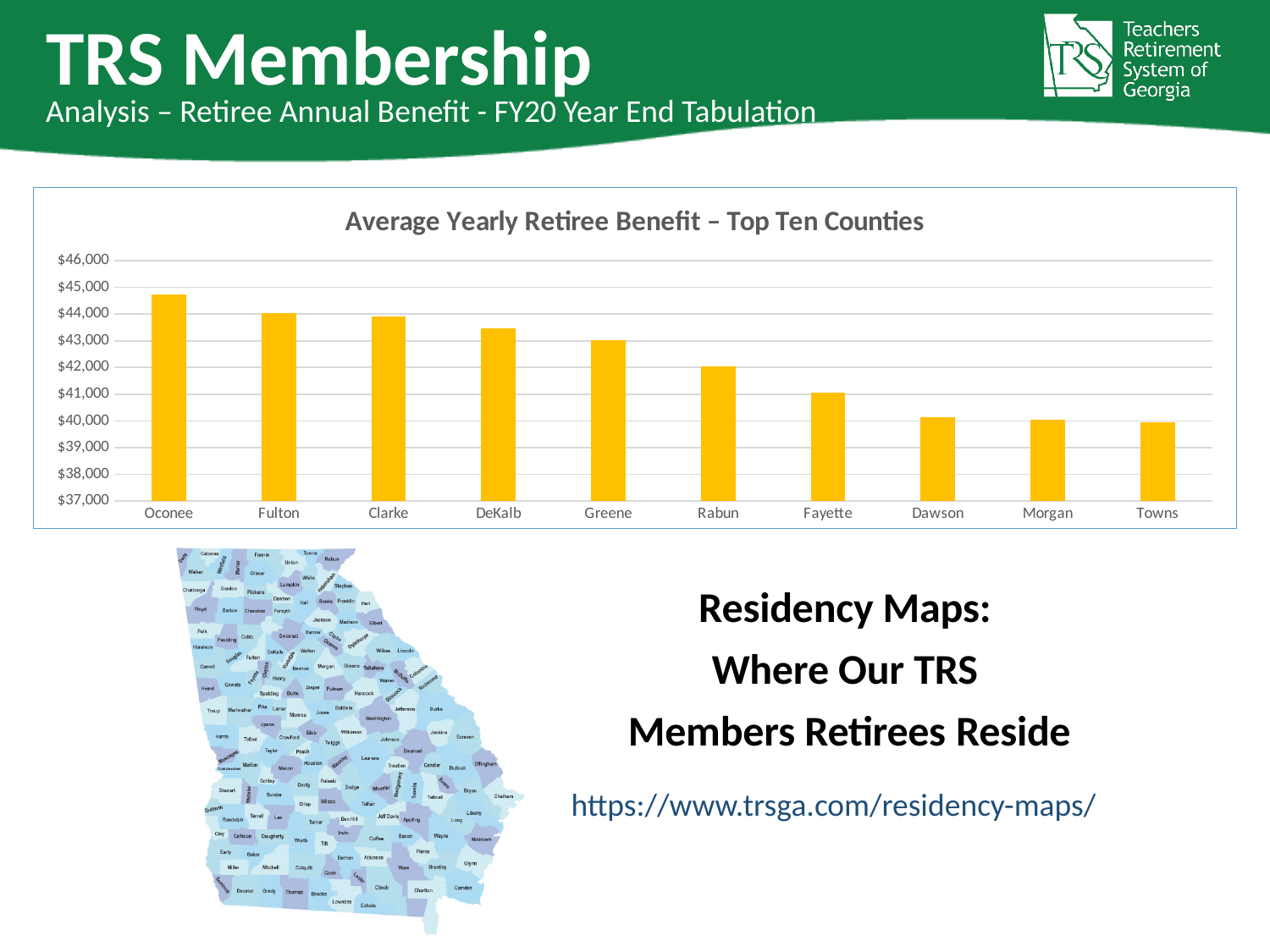
Is the value for Fayette greater or less than $42,000? less Is the value for Greene greater or less than $44,000? less Which county has the highest average yearly retiree benefit? Oconee Is the value for Oconee greater or less than $44,000? greater Which county has the larger average yearly retiree benefit, Greene or Fayette? Greene What kind of chart is shown on the slide? bar chart Do the values rise or fall moving from left to right along the x axis? fall How many counties are shown in the chart? 10 What is the title of the chart? Average Yearly Retiree Benefit – Top Ten Counties Which county has the larger average yearly retiree benefit, Oconee or Rabun? Oconee